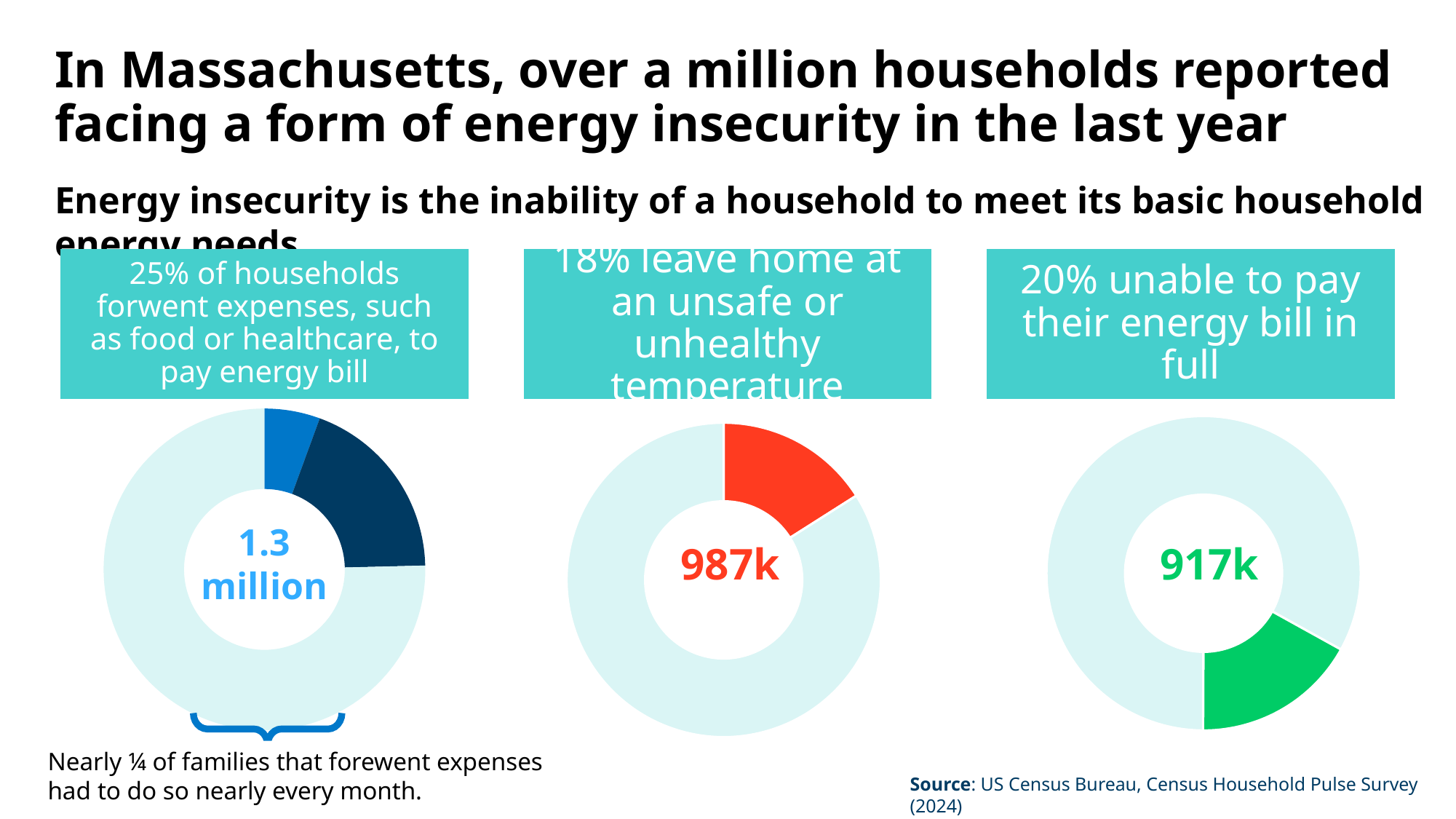
In the right donut chart (unable to pay their energy bill in full), what number is printed in the centre? 917k Which is larger: the 987k in the middle donut chart or the 917k in the right donut chart? 987k What share of households were unable to pay their energy bill in full, according to the right donut chart's heading? 20% In the middle donut chart (leave home at an unsafe or unhealthy temperature), what number is printed in the centre? 987k What kind of chart is used to show the 25% of households that forwent expenses? Donut chart What share of households forwent expenses, such as food or healthcare, to pay their energy bill, according to the left donut chart's heading? 25% What is the difference between the 987k in the middle donut chart and the 917k in the right donut chart? 70k How many donut charts are shown on the slide? 3 What share of households leave home at an unsafe or unhealthy temperature, according to the middle donut chart's heading? 18% In the left donut chart (households that forwent expenses), what number is printed in the centre? 1.3 million What colour is the highlighted slice in the right donut chart (unable to pay energy bill in full)? Green What colour is the highlighted slice in the middle donut chart (unsafe or unhealthy temperature)? Red